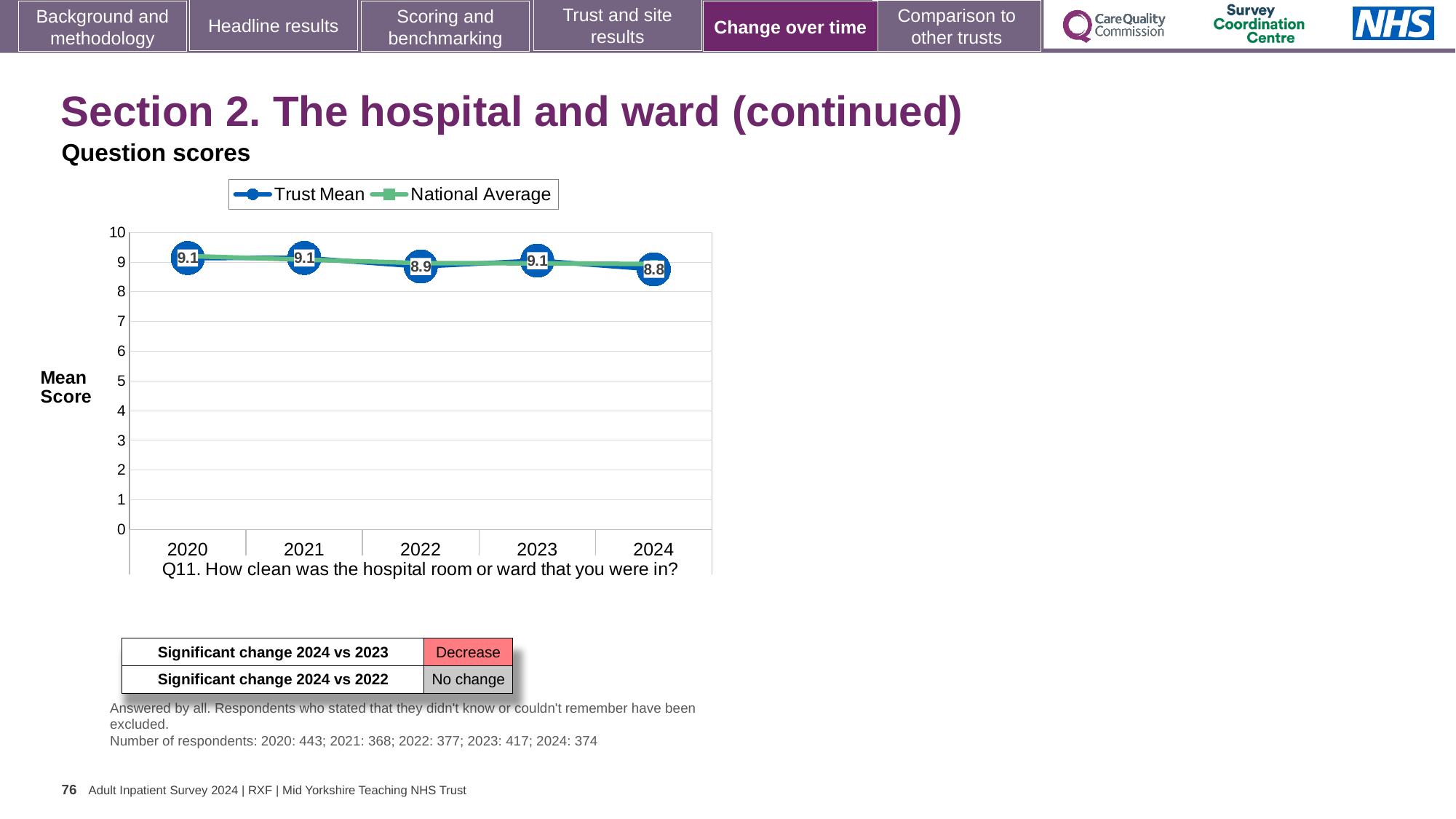
In which year is the Trust Mean score lowest? 2024 Which survey question does the chart relate to? Q11. How clean was the hospital room or ward that you were in? Does the Trust Mean score rise or fall overall from 2020 to 2024? fall Is the National Average value for 2024 greater or less than 8? greater What kind of chart is shown on the slide? line chart Which year has the larger Trust Mean score, 2022 or 2023? 2023 What is the Trust Mean score for 2020? 9.1 What is the Trust Mean score for 2024? 8.8 What is the Trust Mean score for 2022? 8.9 How many years are shown on the x axis of the chart? 5 What is the difference between the Trust Mean score in 2023 and in 2024? 0.3 How many series does the chart legend list? 2